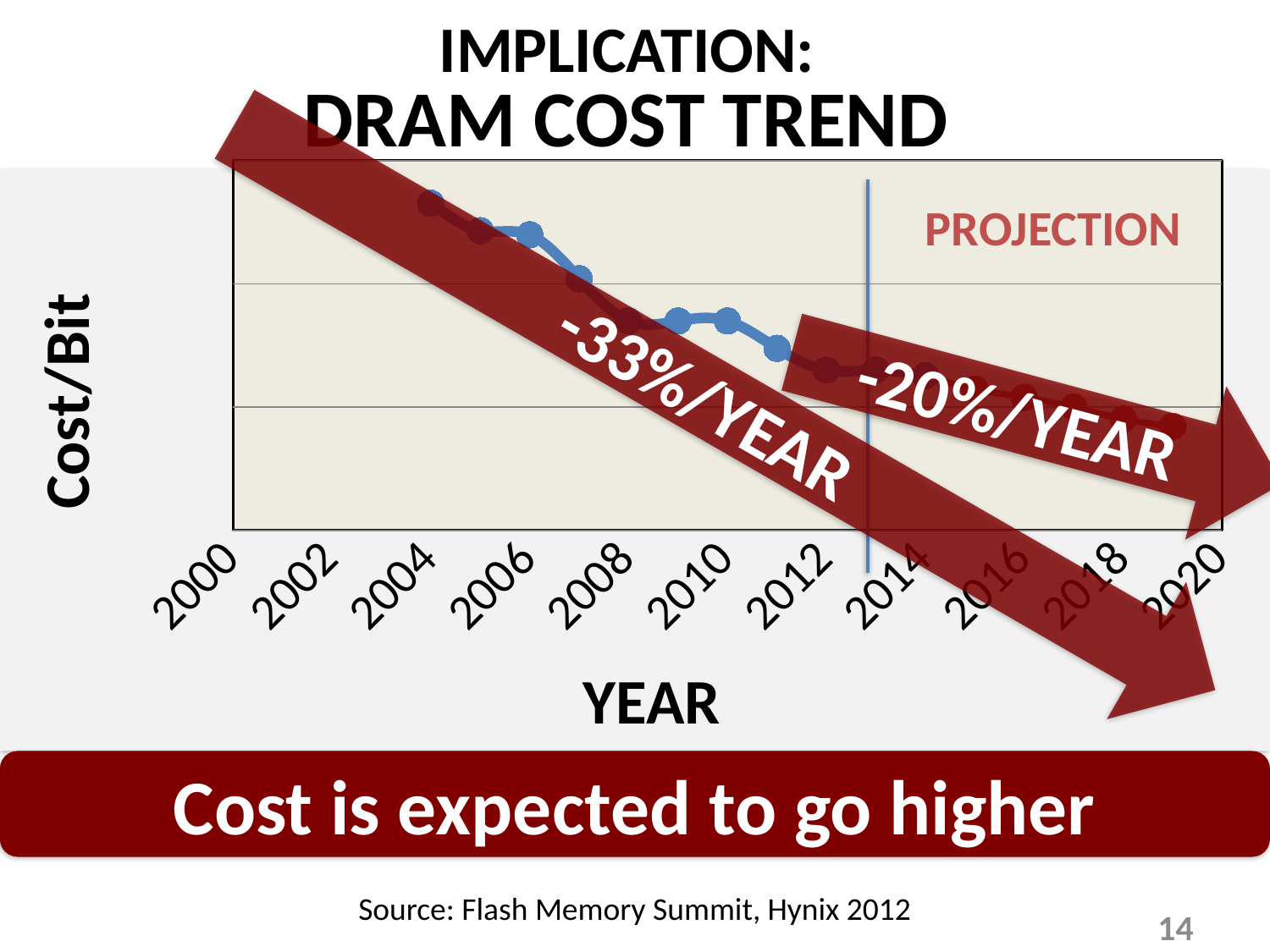
What annual rate of change is annotated on the historical part of the chart? -33%/YEAR What kind of chart is shown on the slide? line chart Which annotated annual rate of decline is steeper, -33%/YEAR or -20%/YEAR? -33%/YEAR What is the title of the chart? IMPLICATION: DRAM COST TREND How many year tick labels are shown on the x axis? 11 What is the interval between consecutive year labels on the x axis? 2 years What is the label of the y axis? Cost/Bit Is the cost/bit plotted for 2012 higher or lower than the cost/bit plotted for 2006? lower What annual rate of change is annotated on the projection part of the chart? -20%/YEAR What is the last year shown on the x axis? 2020 What is the first year shown on the x axis? 2000 Do the plotted values rise or fall as the year increases along the x axis? fall